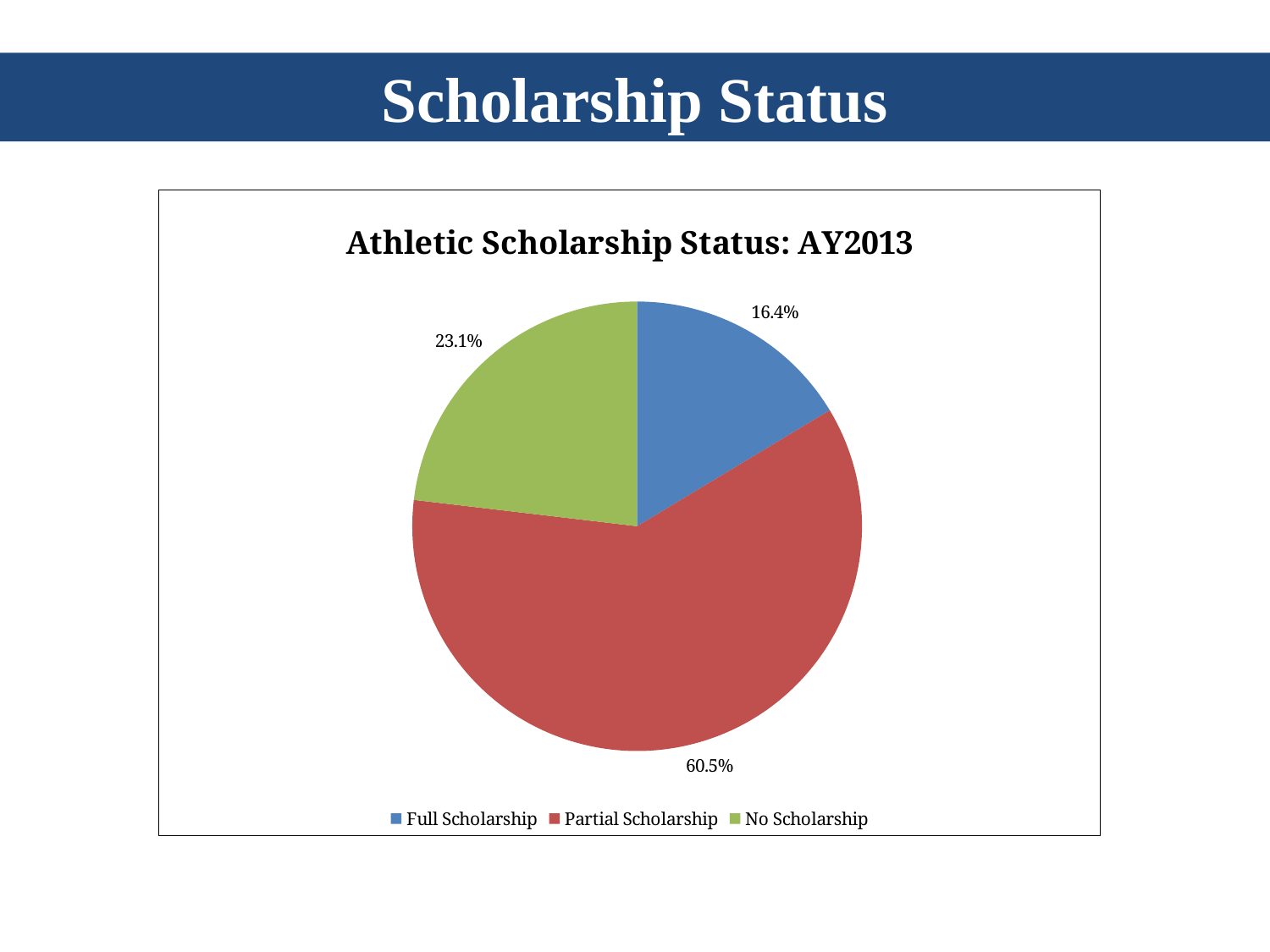
What is the title of the chart? Athletic Scholarship Status: AY2013 What percentage of the pie is Partial Scholarship? 60.5% What percentage of the pie is No Scholarship? 23.1% What percentage of the pie is Full Scholarship? 16.4% Which is larger, the share for No Scholarship or the share for Full Scholarship? No Scholarship What colour represents Partial Scholarship in the chart? red What is the difference in percentage points between Partial Scholarship and No Scholarship? 37.4 How many categories does the legend list? 3 Which category has the largest share of the pie? Partial Scholarship What is the difference in percentage points between No Scholarship and Full Scholarship? 6.7 What type of chart is shown on the slide? pie chart Which category has the smallest share of the pie? Full Scholarship